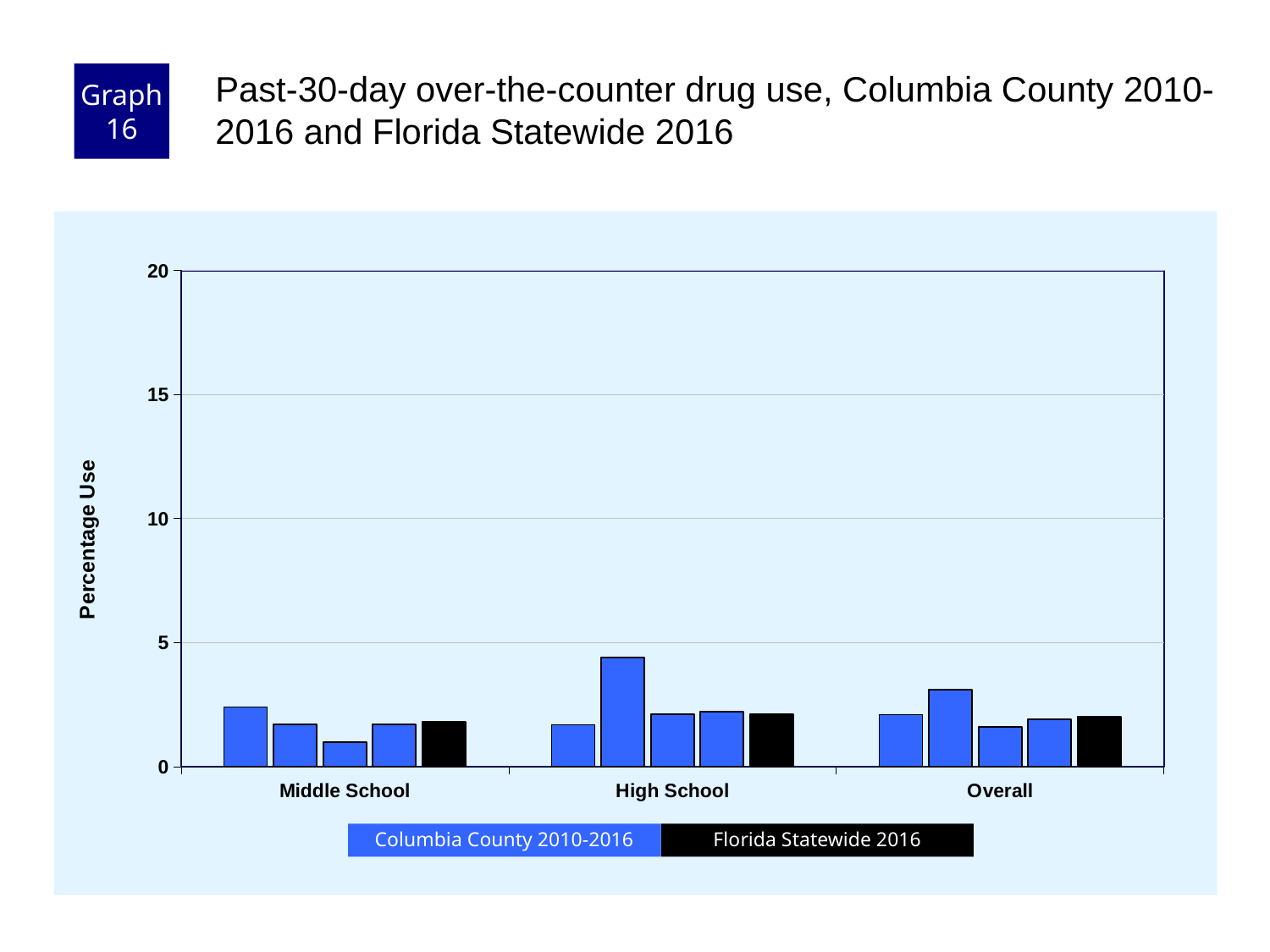
Is the value of the tallest bar in the High School group greater or less than 5? less What colour represents Florida Statewide 2016 in the chart's legend? black How many series does the chart's legend list? 2 Is the Florida Statewide 2016 value for Middle School greater or less than 10? less Is the Florida Statewide 2016 value for Overall greater or less than 5? less How many categories are shown on the x axis of the chart? 3 Which category group contains the tallest bar in the chart? High School Which is larger: the tallest Columbia County bar in the High School group or the tallest Columbia County bar in the Overall group? the tallest Columbia County bar in the High School group Which category group contains the shortest bar in the chart? Middle School What kind of chart is shown on the slide? bar chart What is the label on the chart's y axis? Percentage Use In the Middle School group, which is larger: the shortest Columbia County bar or the Florida Statewide 2016 bar? the Florida Statewide 2016 bar